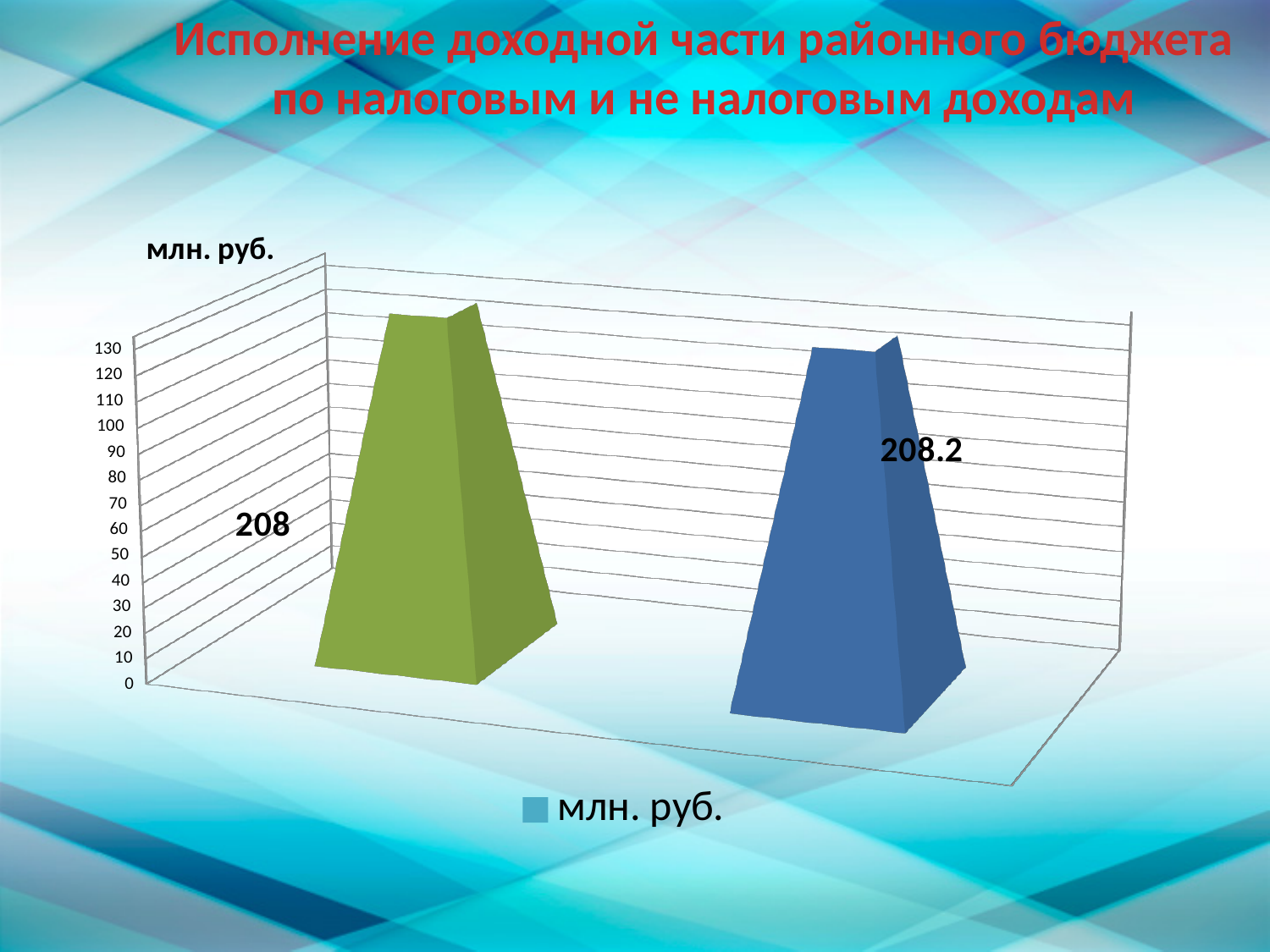
Is the printed value of the blue bar larger or smaller than that of the green bar? larger What value is printed on the green bar? 208 What kind of chart is shown on the slide? bar chart What is the difference between the printed values of the blue bar and the green bar? 0.2 Which bar has the lower printed value, the green one or the blue one? the green bar (208) How many series does the legend list? 1 What is the legend entry of the chart? млн. руб. Which bar has the higher printed value, the green one or the blue one? the blue bar (208.2) What is the highest tick value shown on the vertical axis? 130 What value is printed on the blue bar? 208.2 How many bars are plotted on the chart? 2